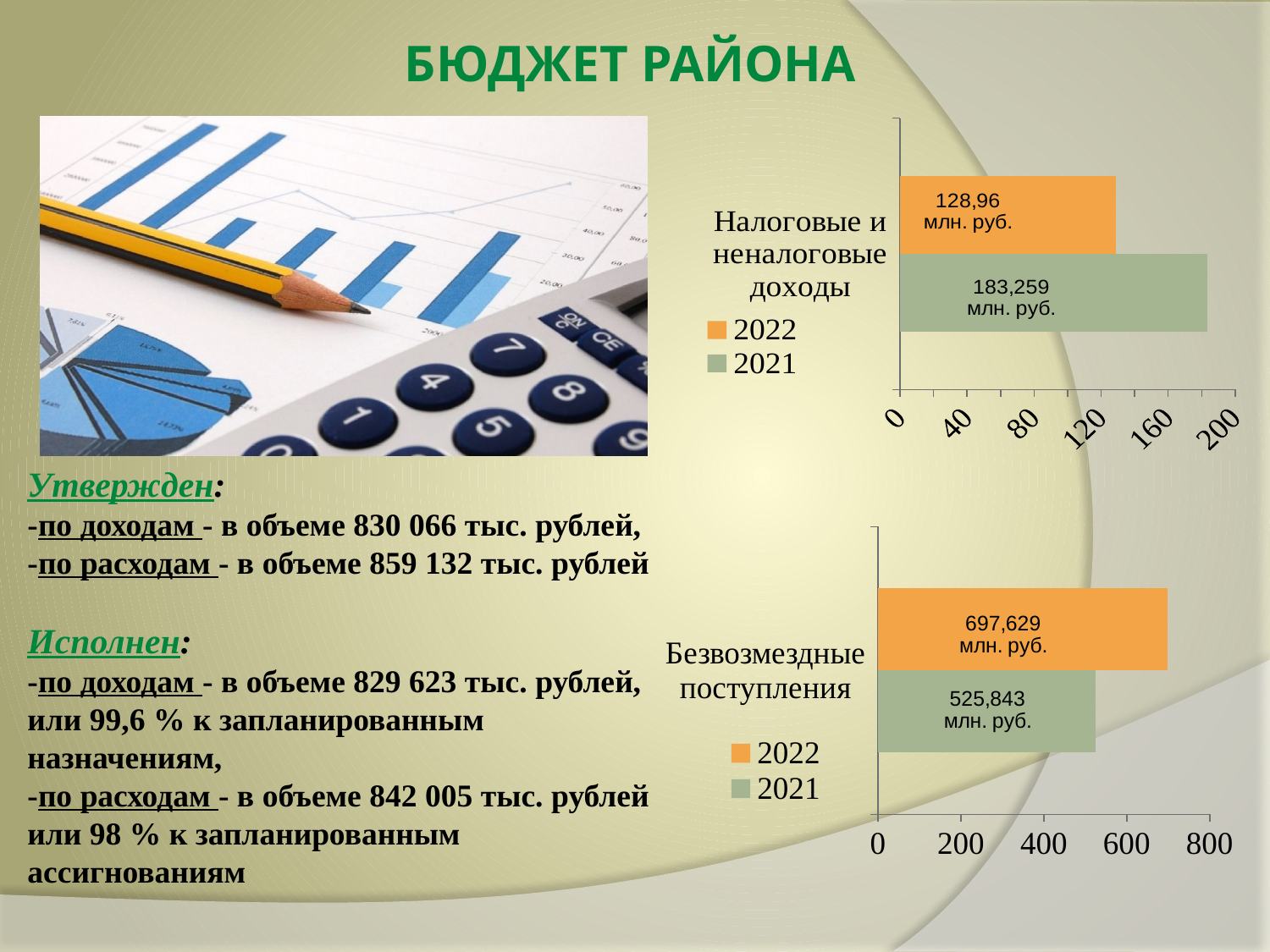
In the 'Налоговые и неналоговые доходы' chart, what is the difference between the 2021 and 2022 values? 54,299 млн. руб. In the 'Налоговые и неналоговые доходы' chart, what is the value for 2021? 183,259 млн. руб. In the 'Безвозмездные поступления' chart, what is the value for 2021? 525,843 млн. руб. In the 'Безвозмездные поступления' chart, which year has the lower value? 2021 In the 'Безвозмездные поступления' chart, what is the value for 2022? 697,629 млн. руб. In the 'Налоговые и неналоговые доходы' chart, which colour represents 2022? orange In the 'Налоговые и неналоговые доходы' chart, which year has the higher value? 2021 In the 'Безвозмездные поступления' chart, what is the difference between the 2022 and 2021 values? 171,786 млн. руб. In the 'Налоговые и неналоговые доходы' chart, what is the value for 2022? 128,96 млн. руб. What kind of chart is the 'Безвозмездные поступления' chart? bar chart How many series does the legend of the 'Налоговые и неналоговые доходы' chart list? 2 In the 'Безвозмездные поступления' chart, is the value for 2022 greater or less than 600? greater